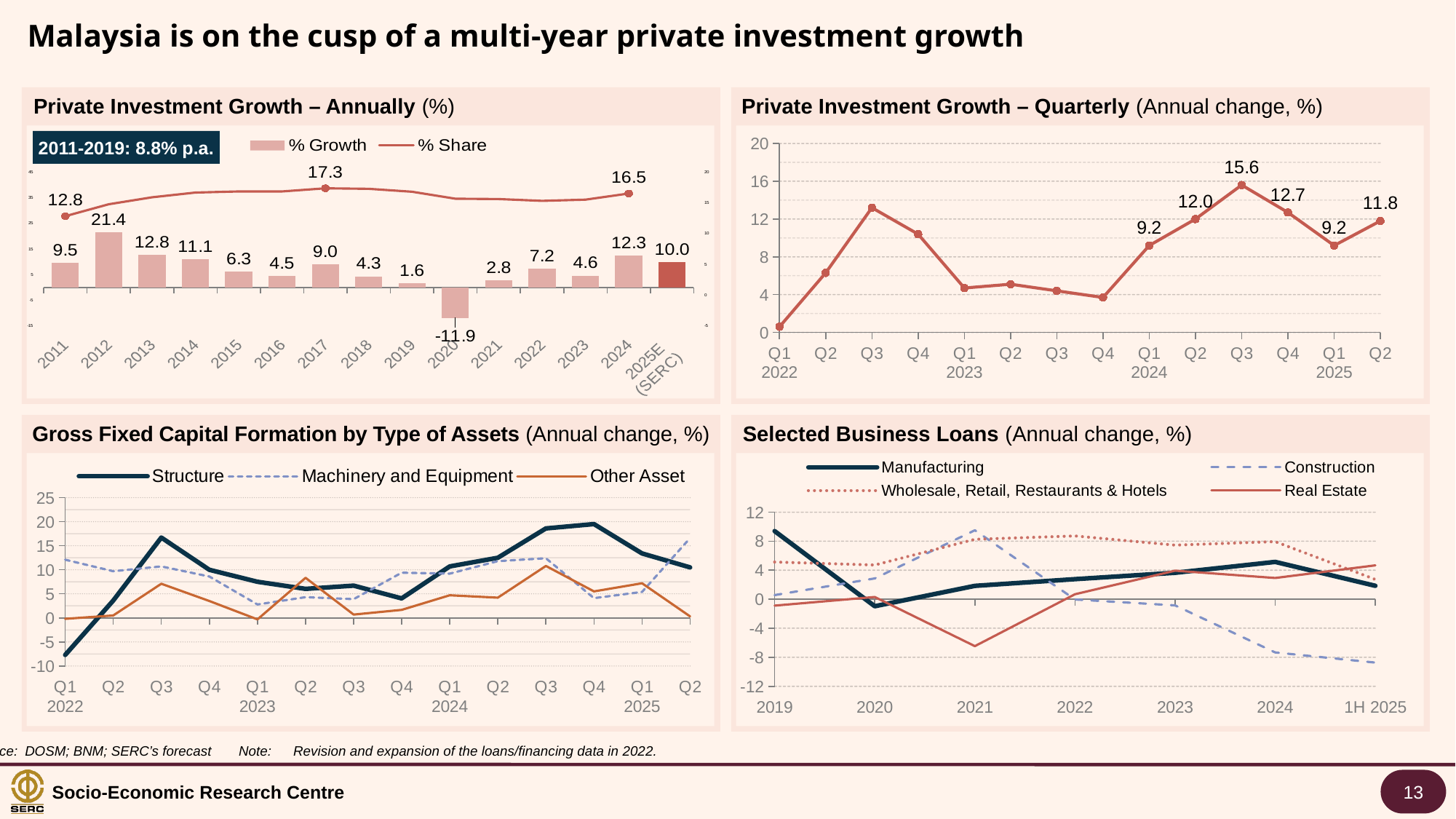
In the Private Investment Growth – Annually chart, which is larger: the % Growth for 2024 or for 2025E (SERC)? 2024 In the Private Investment Growth – Quarterly chart, what is the value for Q3 2024? 15.6 In the Private Investment Growth – Quarterly chart, what is the difference between the Q3 2024 and Q4 2024 values? 2.9 In the Private Investment Growth – Annually chart, what is the % Growth value for 2020? -11.9 How many series does the legend list in the Gross Fixed Capital Formation by Type of Assets chart? 3 In the Private Investment Growth – Annually chart, what is the % Share value labelled for 2017? 17.3 How many series does the legend list in the Selected Business Loans chart? 4 In the Private Investment Growth – Annually chart, what is the difference between the % Growth values for 2024 and 2023? 7.7 In the Gross Fixed Capital Formation by Type of Assets chart, is the Structure value for Q3 2024 greater or less than 15? greater In the Private Investment Growth – Annually chart, which year has the highest % Growth bar? 2012 In the Private Investment Growth – Annually chart, which year has the lowest % Growth bar? 2020 How many quarterly data points are plotted in the Private Investment Growth – Quarterly chart? 14